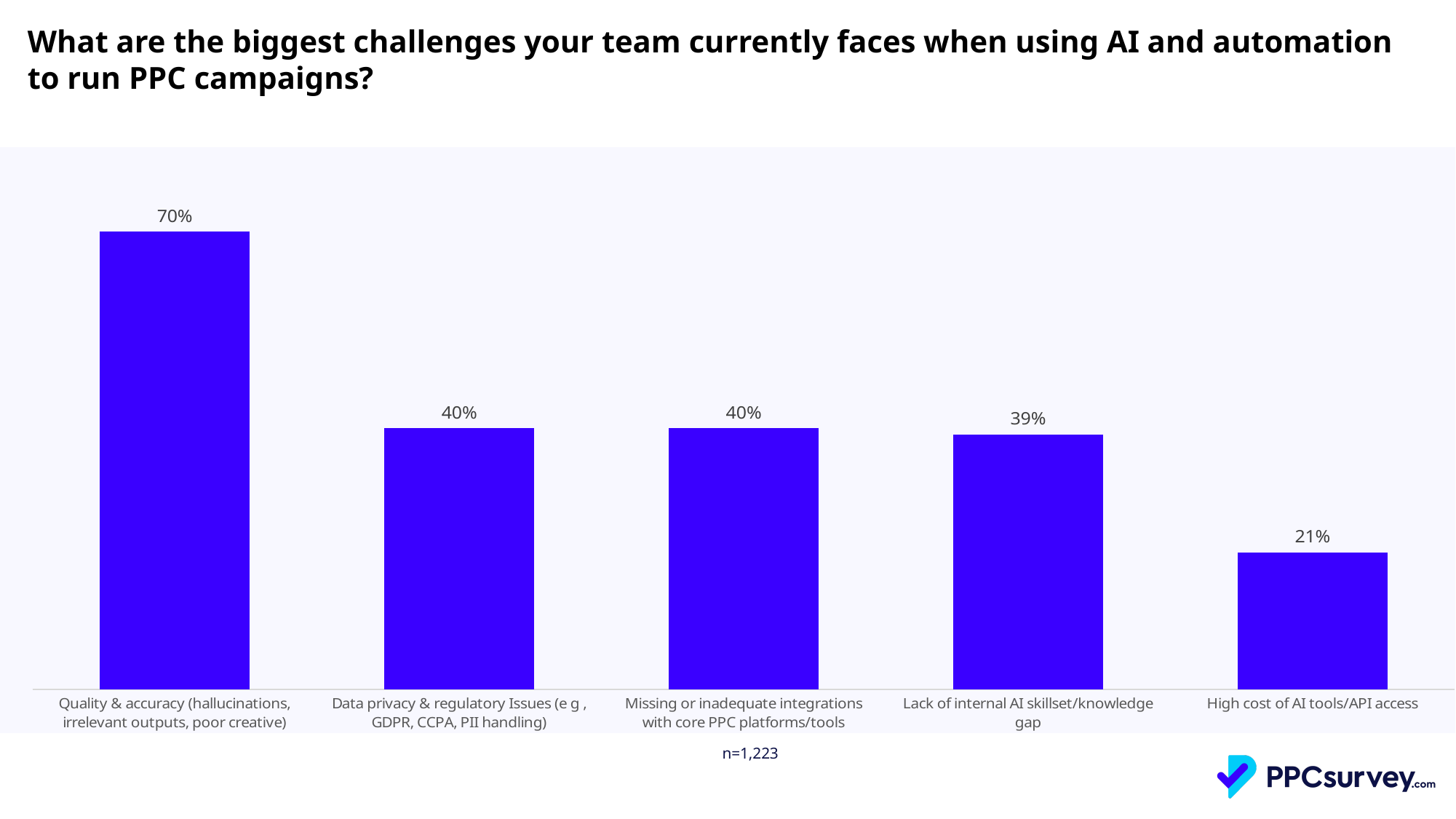
What sample size (n) is shown below the chart? n=1,223 What percentage of respondents cited Quality & accuracy (hallucinations, irrelevant outputs, poor creative) as a challenge? 70% What is the value for High cost of AI tools/API access? 21% What kind of chart is shown on the slide? Bar chart How many challenge categories are shown in the chart? 5 Which challenge has the highest percentage? Quality & accuracy (hallucinations, irrelevant outputs, poor creative) Which is larger: the value for Quality & accuracy or the value for Data privacy & regulatory Issues? Quality & accuracy What is the difference between the value for Quality & accuracy and the value for High cost of AI tools/API access? 49% Which challenge has the lowest percentage? High cost of AI tools/API access What is the difference between the value for Missing or inadequate integrations with core PPC platforms/tools and the value for Lack of internal AI skillset/knowledge gap? 1% What is the value for Lack of internal AI skillset/knowledge gap? 39% What is the value for Data privacy & regulatory Issues (e.g., GDPR, CCPA, PII handling)? 40%